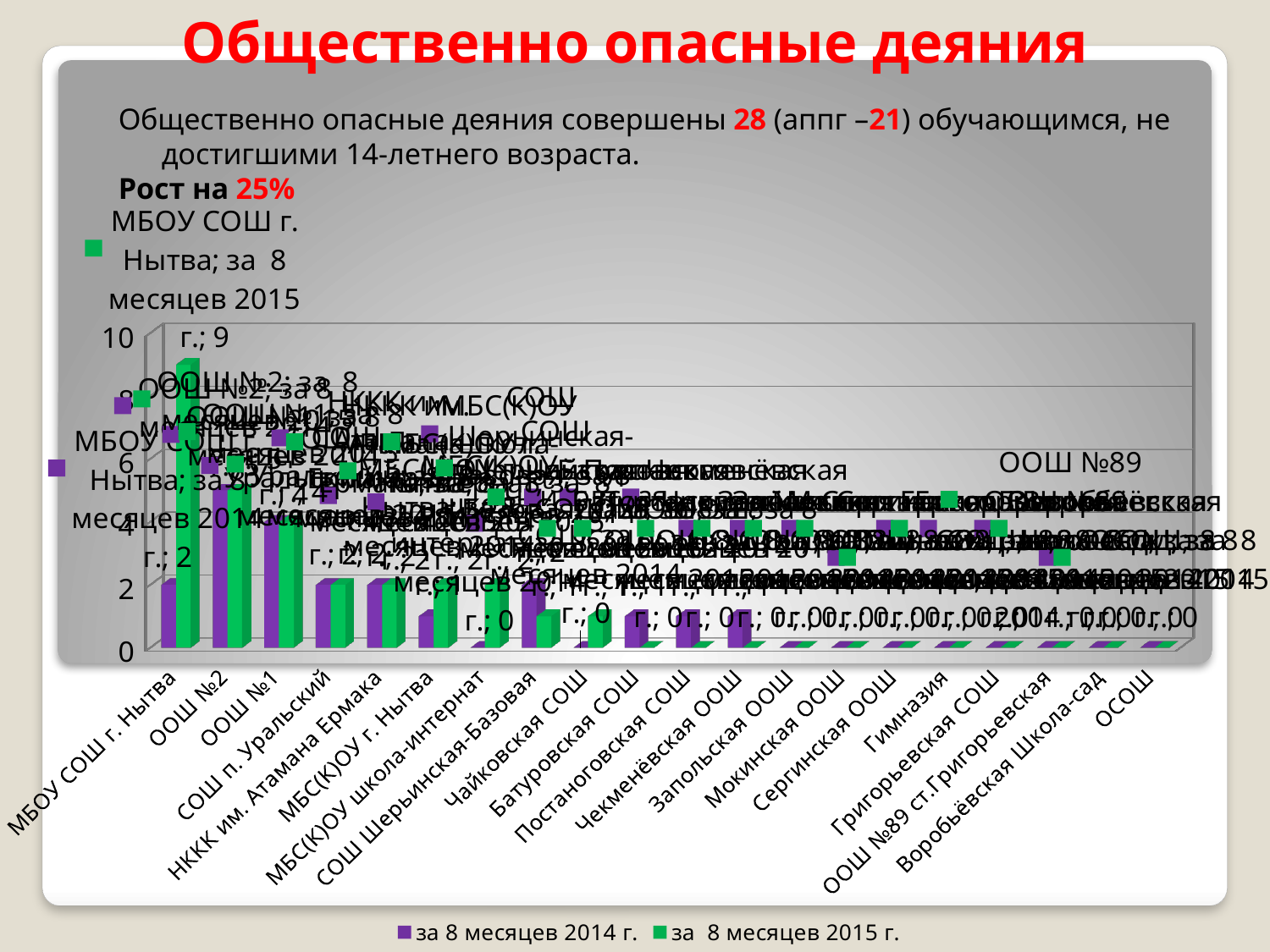
How many schools (categories) are shown along the x axis of the chart? 20 Which school has the highest bar in the series 'за 8 месяцев 2015 г.'? МБОУ СОШ г. Нытва Is the value for МБОУ СОШ г. Нытва in the series 'за 8 месяцев 2015 г.' greater or less than 8? greater What kind of chart is shown on the slide? bar chart Is the value for ООШ №2 in the series 'за 8 месяцев 2015 г.' greater or less than 4? greater What is the value for МБОУ СОШ г. Нытва in the series 'за 8 месяцев 2015 г.'? 9 How many series does the chart legend list? 2 What are the two series named in the chart legend? за 8 месяцев 2014 г. and за 8 месяцев 2015 г. By how much does the 2015 value for МБОУ СОШ г. Нытва exceed its 2014 value? 7 Which colour represents the series 'за 8 месяцев 2015 г.' in the chart? green For МБОУ СОШ г. Нытва, which series has the larger value: 'за 8 месяцев 2014 г.' or 'за 8 месяцев 2015 г.'? за 8 месяцев 2015 г. What is the value for МБОУ СОШ г. Нытва in the series 'за 8 месяцев 2014 г.'? 2